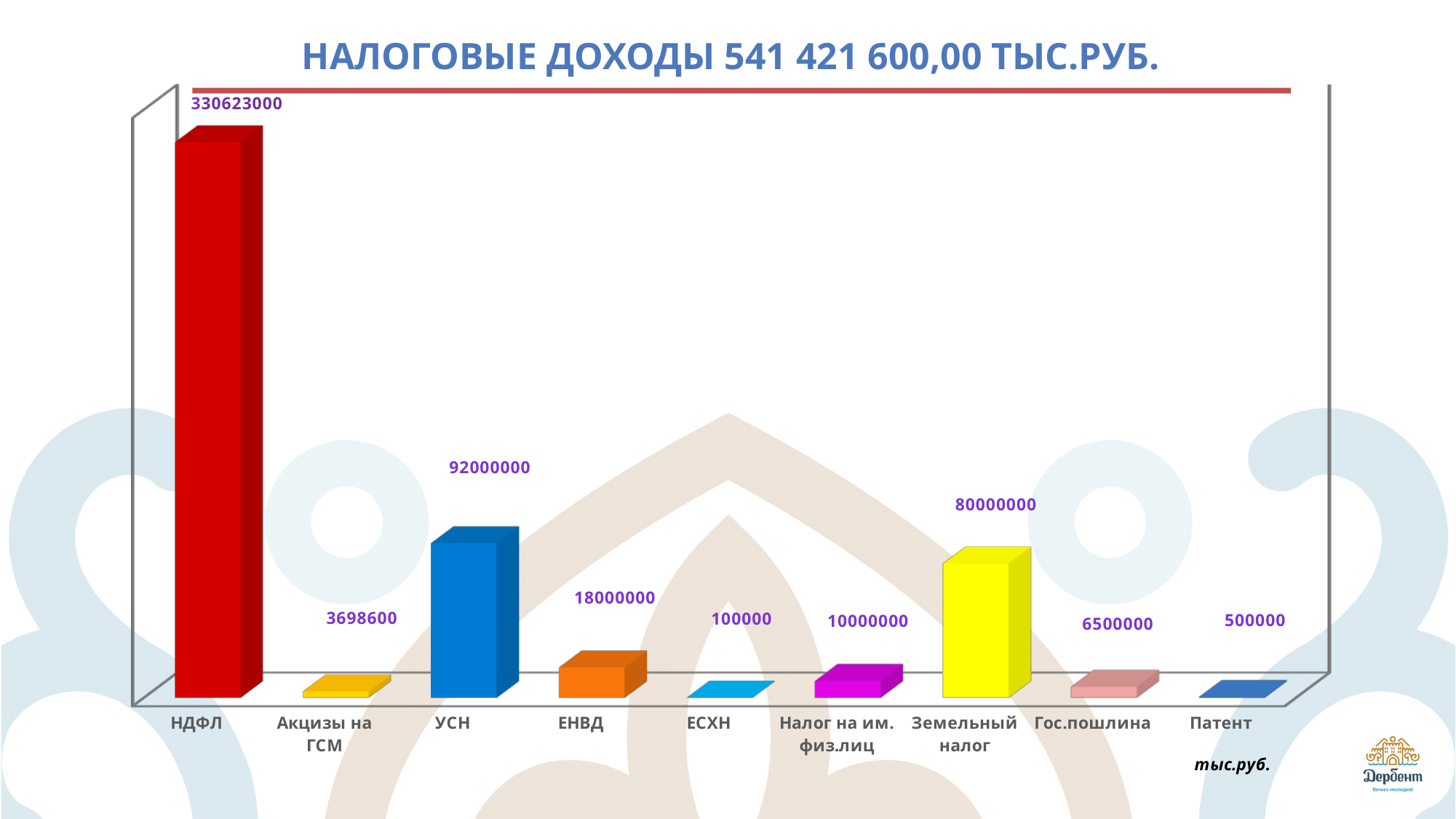
How many categories are shown on the chart? 9 Which category has the highest value? НДФЛ Which category has the lowest value? ЕСХН What is the value for НДФЛ? 330623000 What is the value for Акцизы на ГСМ? 3698600 What is the value for УСН? 92000000 What is the difference between the values for УСН and Земельный налог? 12000000 What is the difference between the values for ЕНВД and Налог на им. физ.лиц? 8000000 What is the title of the chart? НАЛОГОВЫЕ ДОХОДЫ 541 421 600,00 ТЫС.РУБ. What is the value for Земельный налог? 80000000 Which is larger, the value for Гос.пошлина or the value for Патент? Гос.пошлина What kind of chart is shown on the slide? bar chart